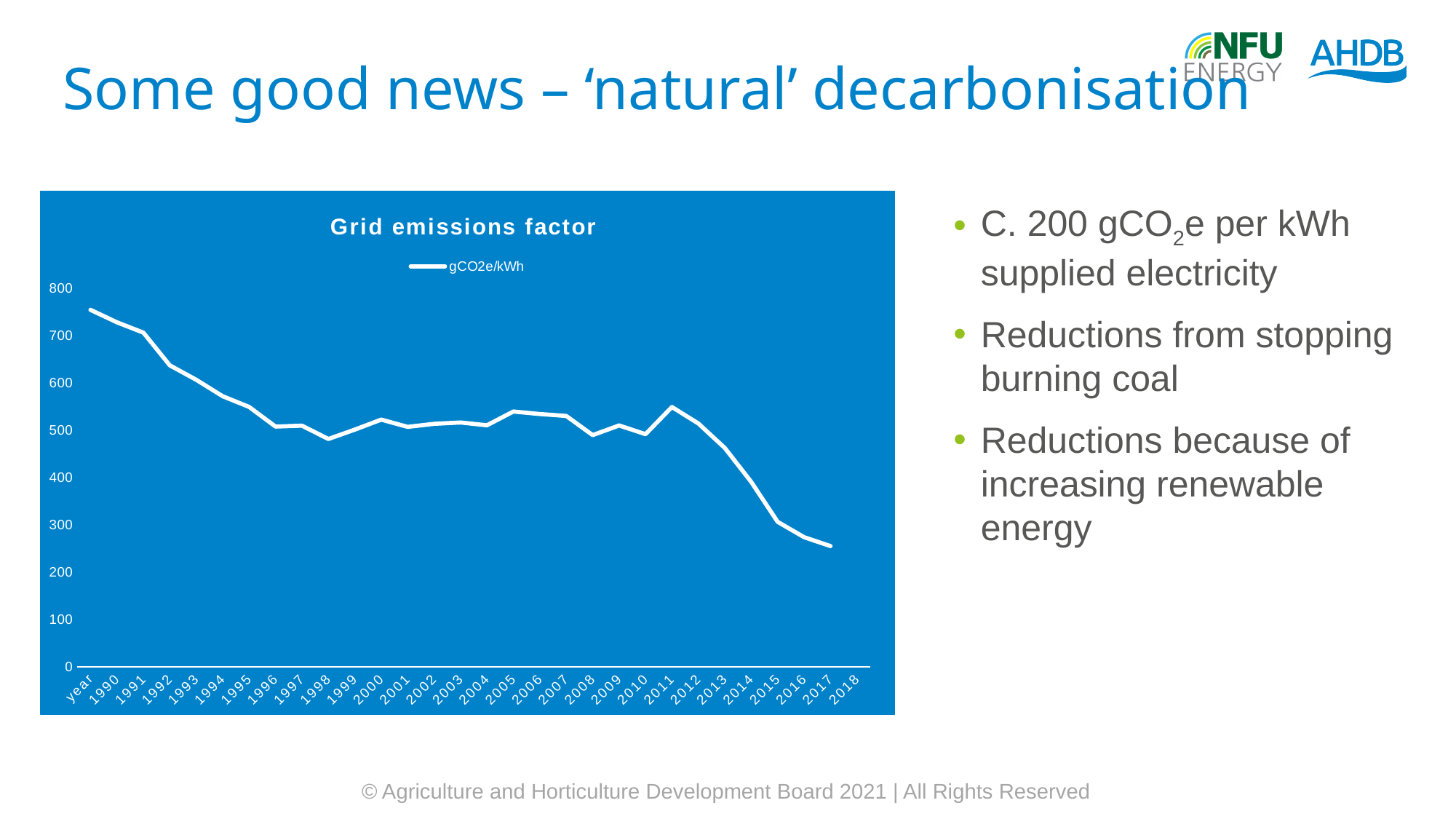
Is the value at the peak around the 2011 label greater or less than 500? greater What is the name of the series shown in the chart's legend? gCO2e/kWh Is the lowest value on the Grid emissions factor line greater or less than 200? greater Is the highest value on the Grid emissions factor line greater or less than 800? less What is the title of the chart? Grid emissions factor Overall, do the values in the Grid emissions factor chart rise or fall from left to right along the x axis? fall What is the highest tick value shown on the y axis of the chart? 800 How many series does the chart's legend list? 1 What kind of chart is shown on the slide? line chart Which is larger on the Grid emissions factor line: the first plotted value or the last plotted value? the first plotted value